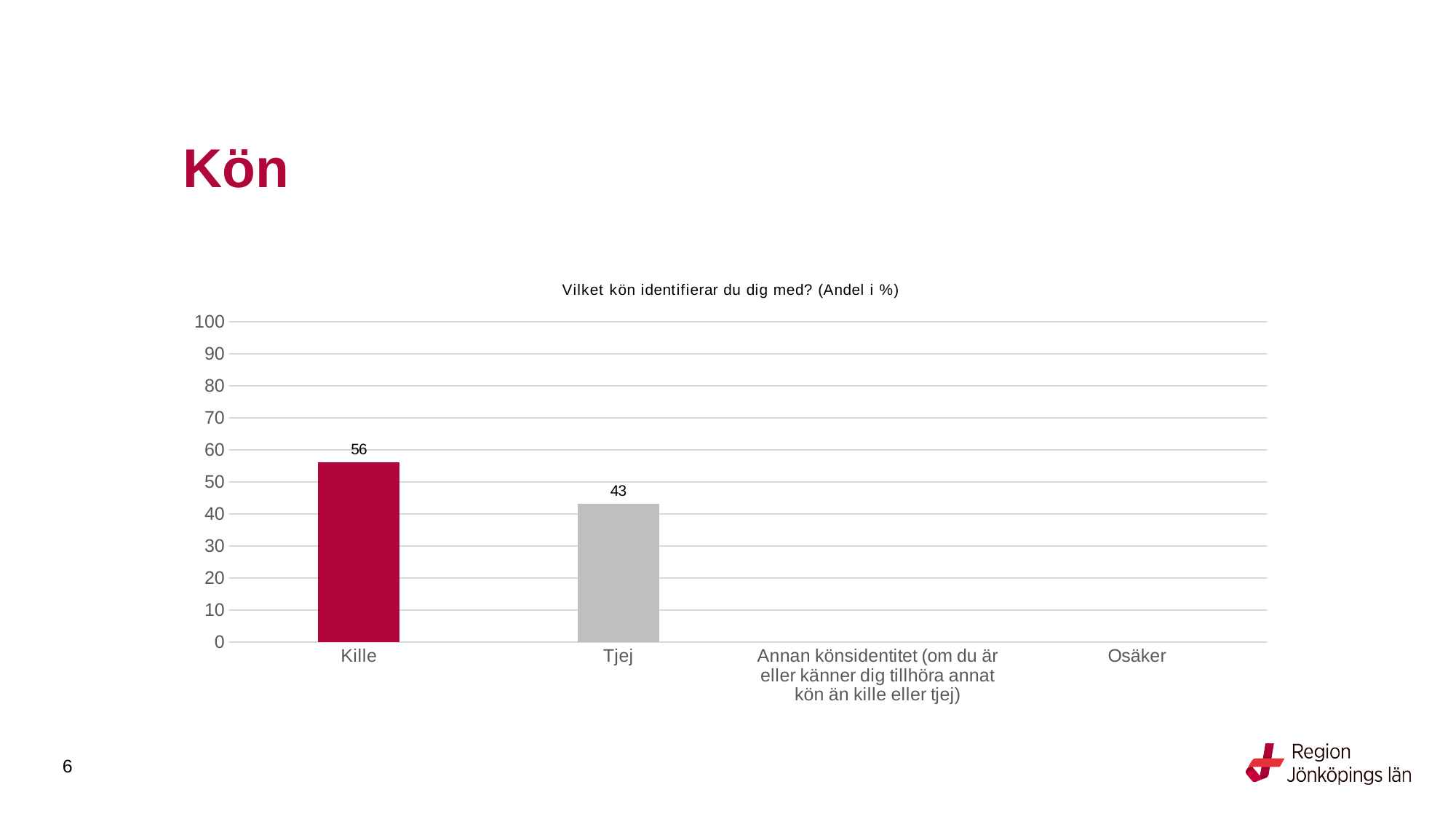
Is the value for Tjej greater or less than 50? less What kind of chart is shown on the slide? Bar chart What colour is the bar for Kille? Red Which is larger, the value for Kille or the value for Tjej? Kille What is the difference between the values for Kille and Tjej? 13 Which category has the highest value? Kille How many categories are shown on the x axis? 4 What is the value for Kille? 56 What is the value for Tjej? 43 What is the title of the chart? Vilket kön identifierar du dig med? (Andel i %) What is the highest value shown on the y axis? 100 Is the value for Kille greater or less than 50? greater